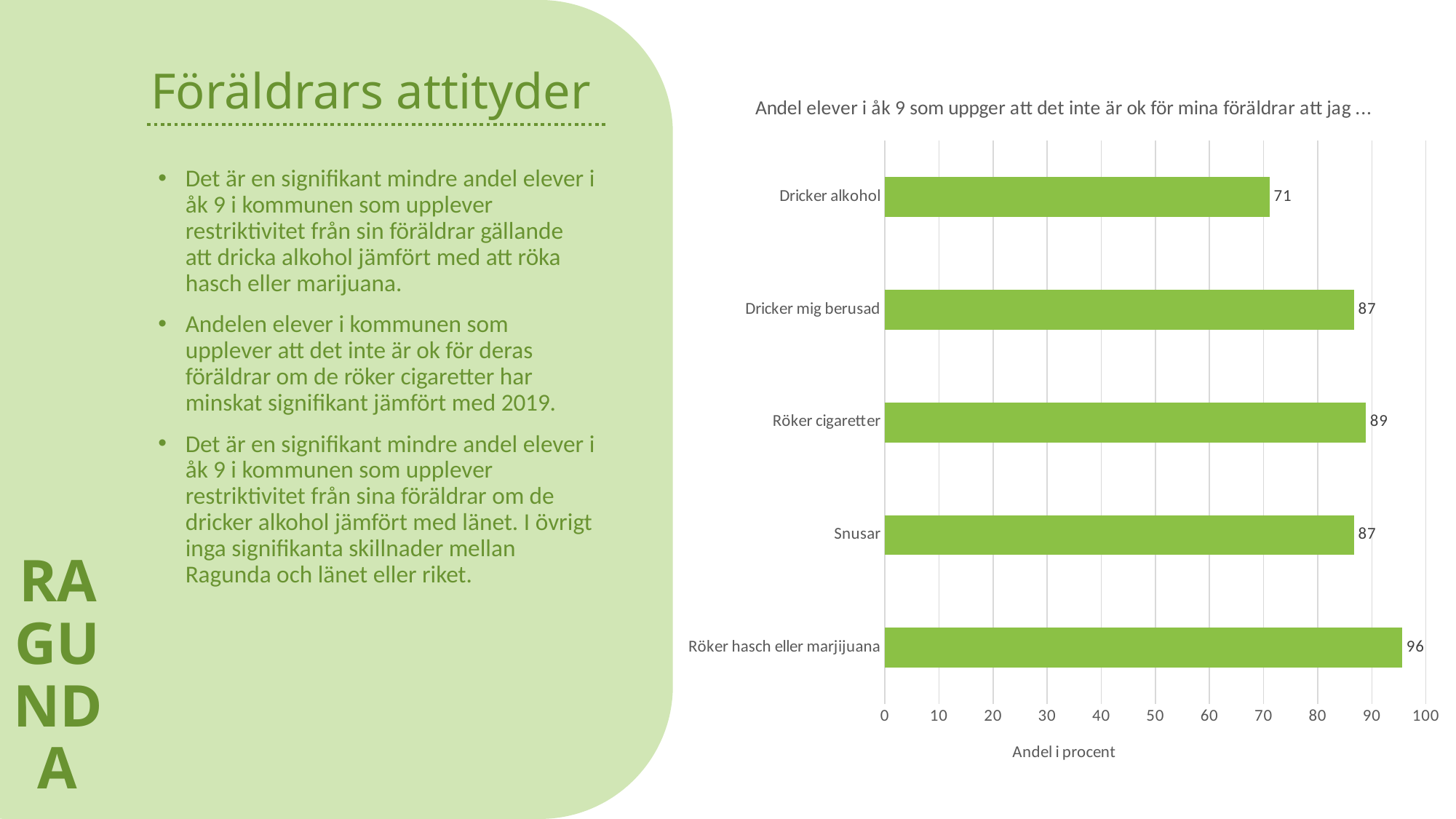
What is the value for Röker cigaretter? 89 How many categories are shown in the chart? 5 Which category has the lowest value? Dricker alkohol Is the value for Dricker mig berusad greater or less than 80? greater What is the difference between the values for Röker hasch eller marjijuana and Dricker alkohol? 25 Which category has the highest value? Röker hasch eller marjijuana What is the difference between the values for Röker cigaretter and Dricker mig berusad? 2 What kind of chart is shown on the slide? bar chart Which is larger, the value for Röker cigaretter or the value for Dricker alkohol? Röker cigaretter What is the value for Dricker alkohol? 71 What is the value for Snusar? 87 What is the label of the horizontal axis? Andel i procent